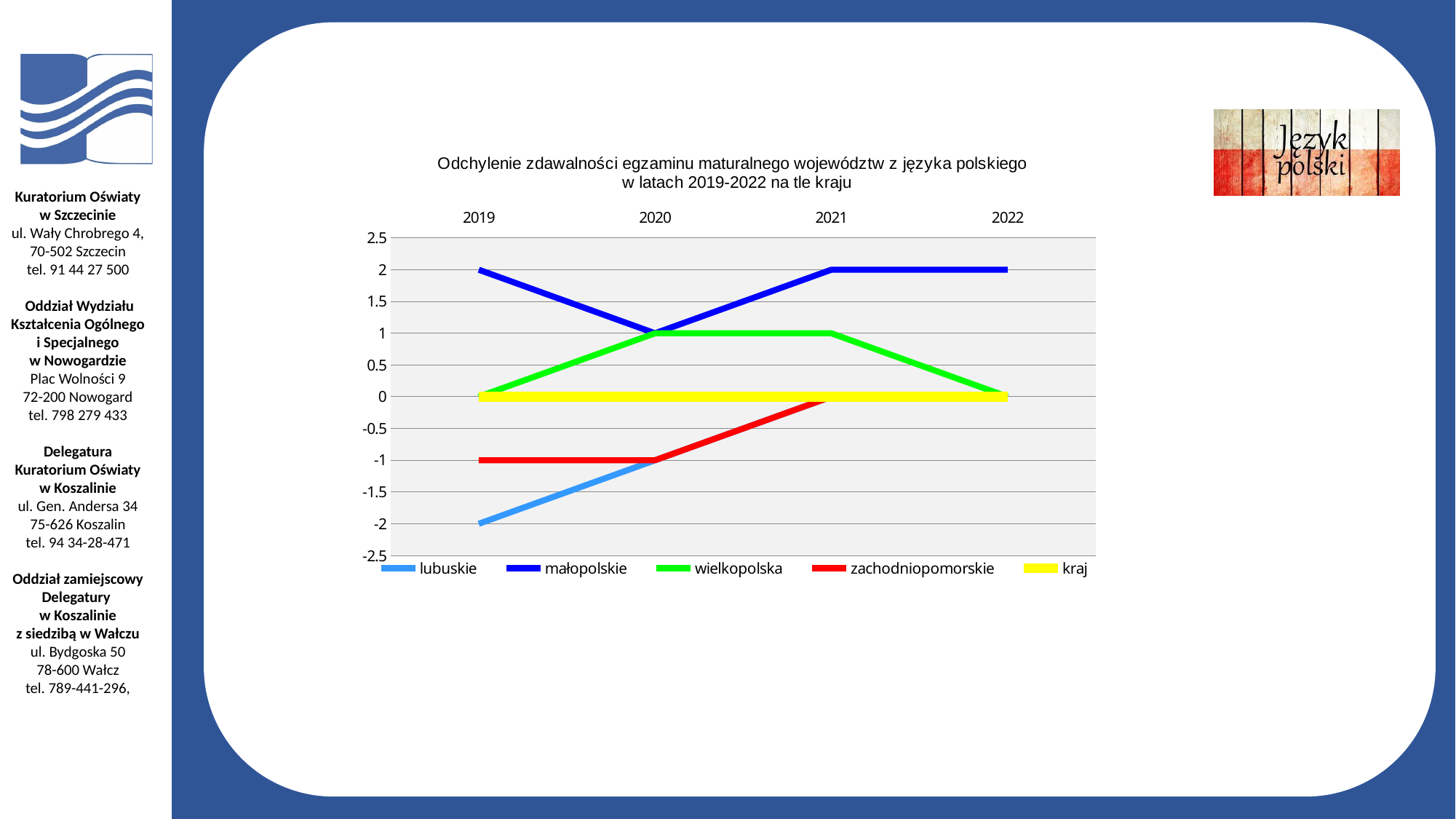
How many years are shown on the x axis? 4 Does the value for lubuskie rise or fall from 2019 to 2020? rise What is the difference between the values for małopolskie and lubuskie in 2019? 4 What is the value for wielkopolska in 2021? 1 Which series has the lowest value in 2019? lubuskie What is the value for zachodniopomorskie in 2020? -1 What is the value for małopolskie in 2019? 2 How many series does the legend list? 5 What is the value for lubuskie in 2019? -2 What kind of chart is shown on the slide? line chart Which series has the highest value in 2019? małopolskie Which series is drawn in yellow? kraj